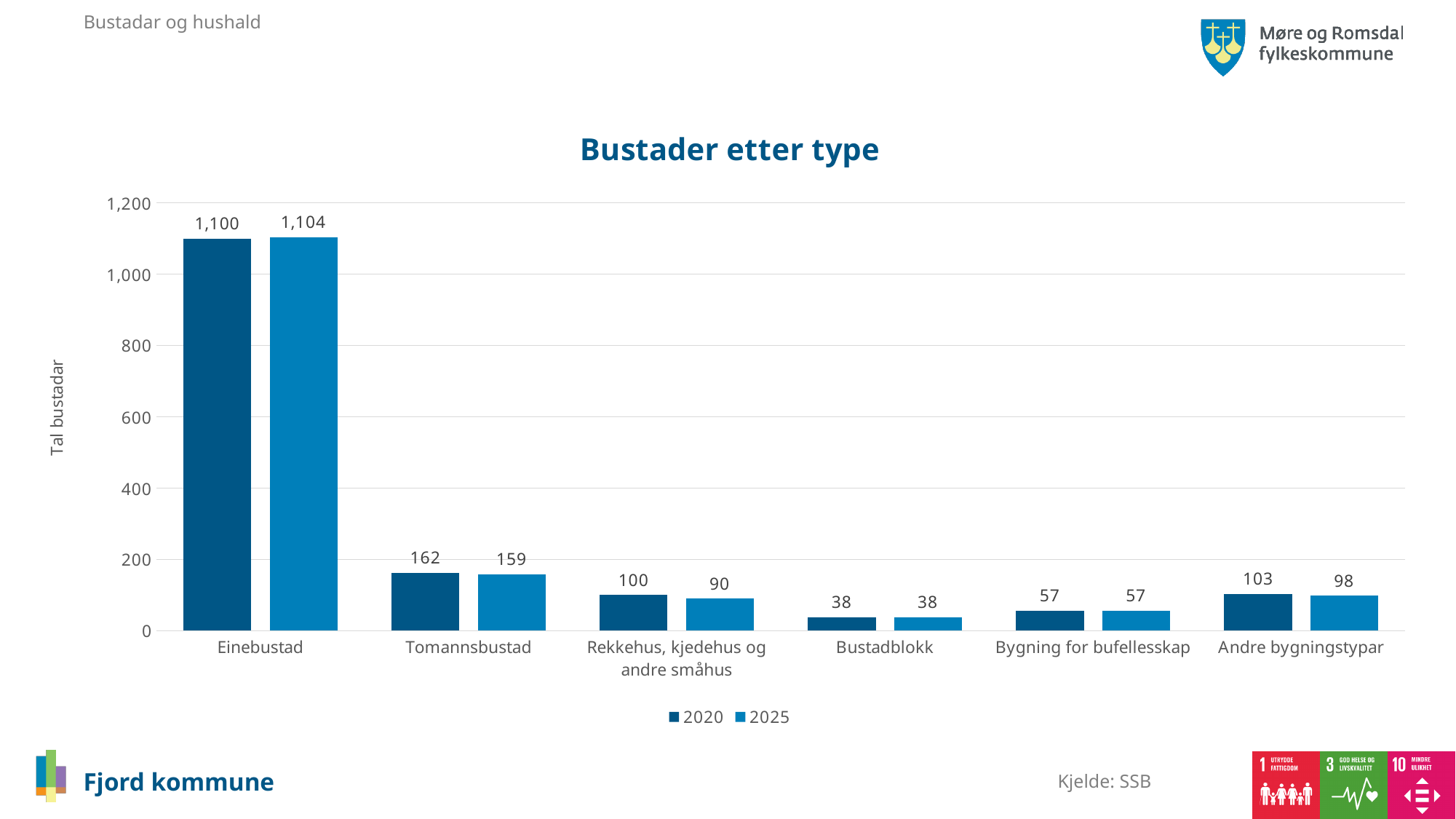
How many categories are shown on the x axis? 6 What is the value for Tomannsbustad in 2020? 162 What is the difference between the 2020 and 2025 values for Andre bygningstypar? 5 What is the value for Rekkehus, kjedehus og andre småhus in 2025? 90 Which is larger for Tomannsbustad: the 2020 value or the 2025 value? 2020 Which category has the lowest value in 2025? Bustadblokk What is the value for Einebustad in 2025? 1,104 What kind of chart is shown? Bar chart Is the value for Einebustad in 2020 greater or less than 1,000? greater What is the title of the chart? Bustader etter type How many series does the legend list? 2 Which category has the highest value in 2020? Einebustad